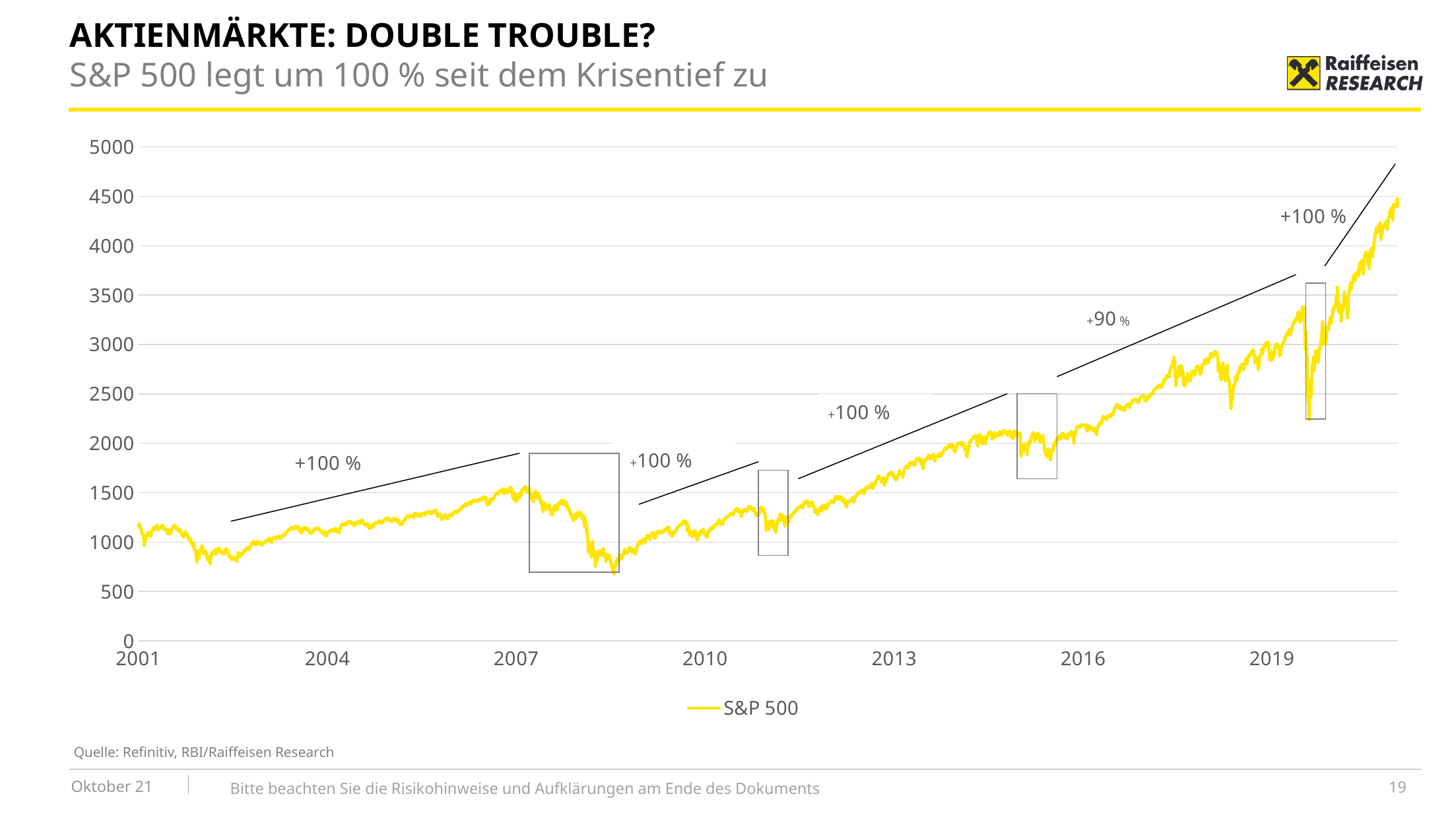
Which is larger, the S&P 500 value at the start of 2004 or at the start of 2019? 2019 Is the value of the S&P 500 at the start of 2010 greater or less than 1500? less Is the lowest value of the S&P 500 line greater or less than 1000? less Overall, does the S&P 500 line rise or fall from 2001 to the end of the chart? rise Is the highest value reached by the S&P 500 line greater or less than 4000? greater How many series does the legend list? 1 What is the name of the series shown in the legend? S&P 500 What kind of chart is shown on the slide? line chart What percentage gain is annotated on the segment between 2016 and 2019? +90 %